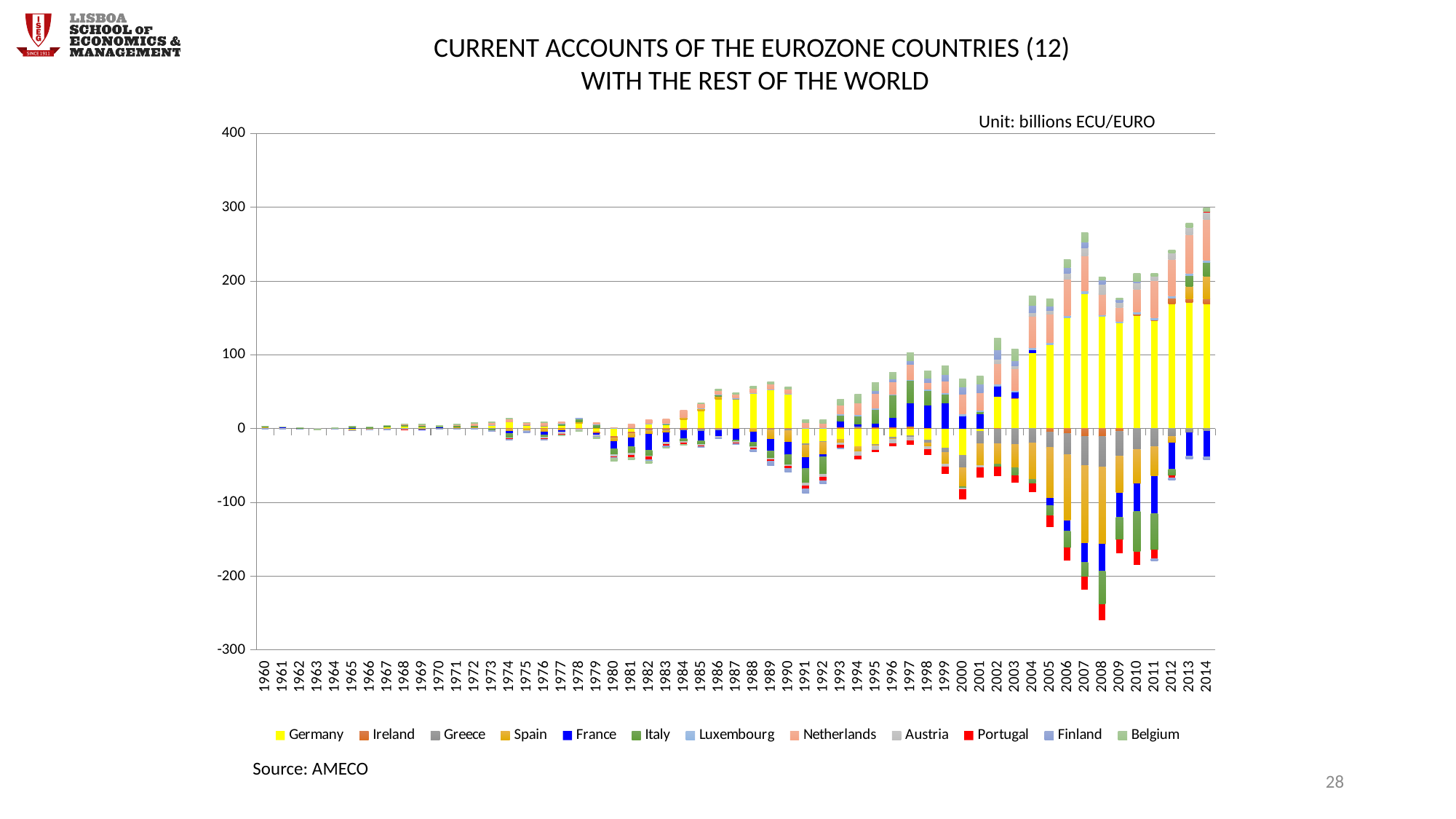
In which year does the negative part of the stacked bar reach its lowest point? 2008 Which year has the taller positive stack, 2007 or 2014? 2014 What is the first year shown on the x axis? 1960 Is the Germany segment in 2007 greater or less than 100? greater Is the top of the positive stack in 2014 greater or less than 200? greater In which year does the positive part of the stacked bar reach its highest point? 2014 How many series does the legend list? 12 What unit is stated for the values in the chart? billions ECU/EURO From 2011 to 2014, does the top of the positive stack rise or fall? rise Is the bottom of the negative stack in 2008 greater or less than -200? less What kind of chart is shown on the slide? Stacked bar chart How many years are shown along the x axis? 55